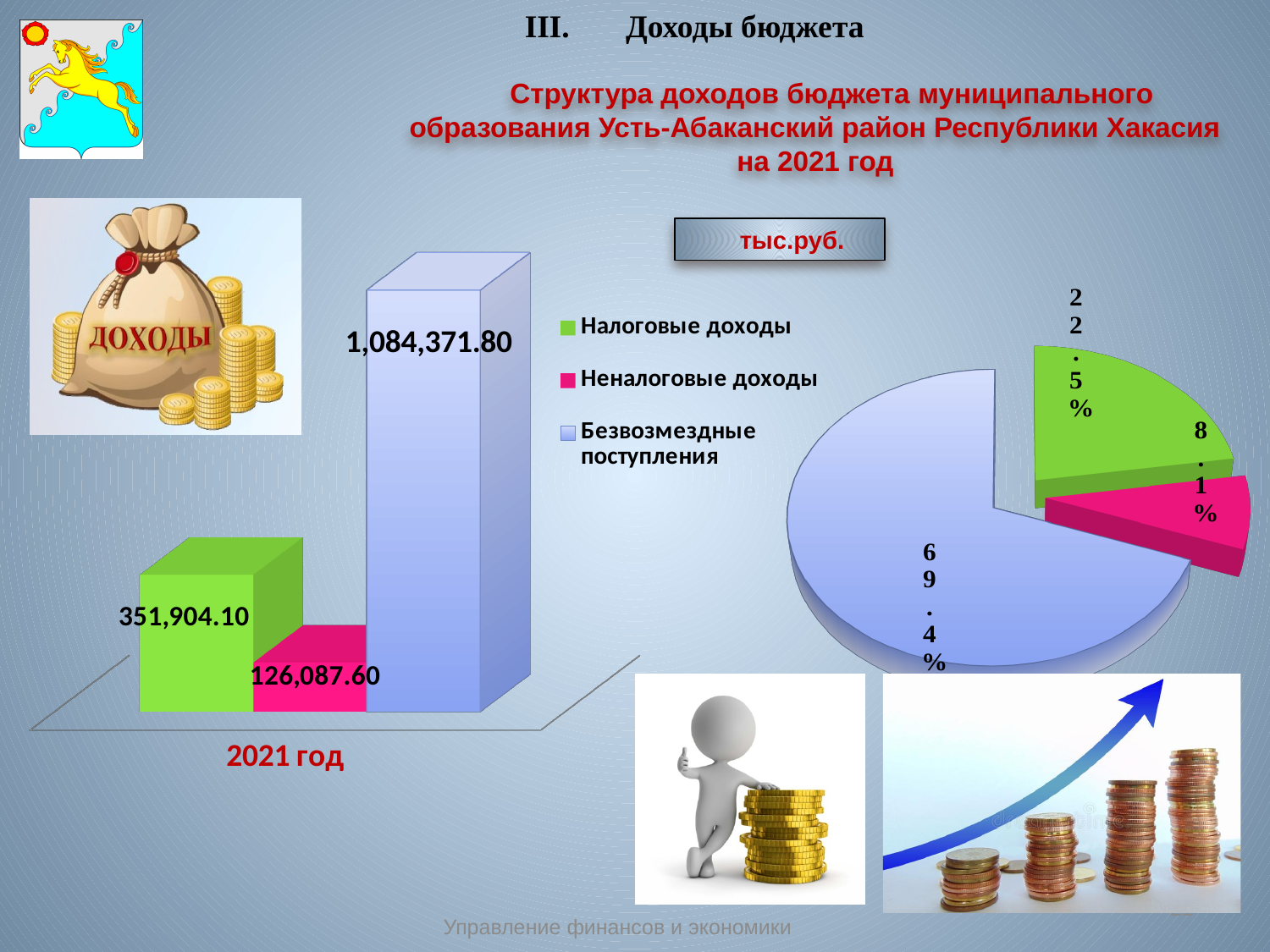
On the bar chart on the left, which series has the highest value? Безвозмездные поступления On the pie chart on the right, what share does the green slice (Налоговые доходы) have? 22.5% On the bar chart on the left, what is the value for Неналоговые доходы? 126,087.60 On the bar chart on the left, what is the value for Безвозмездные поступления? 1,084,371.80 On the pie chart on the right, what share does the blue slice (Безвозмездные поступления) have? 69.4% What kind of chart is shown on the left of the slide? bar chart How many series does the legend list? 3 On the bar chart on the left, what is the difference between Налоговые доходы and Неналоговые доходы? 225,816.50 On the bar chart on the left, what is the value for Налоговые доходы? 351,904.10 What year label is shown under the bar chart on the left? 2021 год On the bar chart on the left, which is larger: Налоговые доходы or Неналоговые доходы? Налоговые доходы On the bar chart on the left, which series has the lowest value? Неналоговые доходы